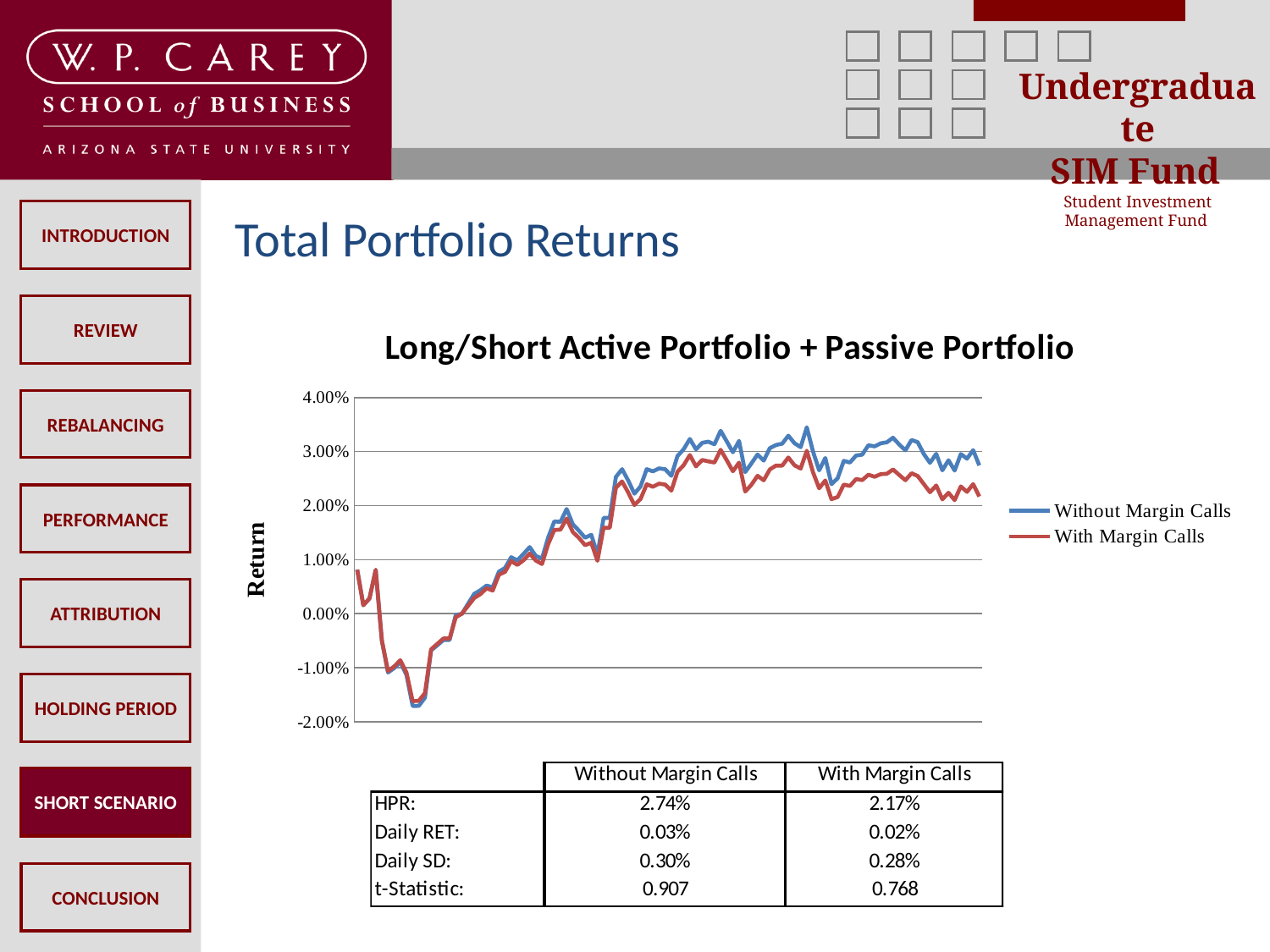
Is the lowest point of the Without Margin Calls series greater or less than -1.00%? less What is the title of the chart? Long/Short Active Portfolio + Passive Portfolio Is the highest point of the Without Margin Calls series greater or less than 3.00%? greater How many series does the chart legend list? 2 What kind of chart is shown on the slide? line chart Is the starting value of the Without Margin Calls series greater or less than 0.00%? greater Which series ends higher at the right end of the chart, Without Margin Calls or With Margin Calls? Without Margin Calls Overall, do the returns rise or fall from the left to the right of the chart? rise Which series reaches the higher peak, Without Margin Calls or With Margin Calls? Without Margin Calls Which colour is used for the With Margin Calls series? red